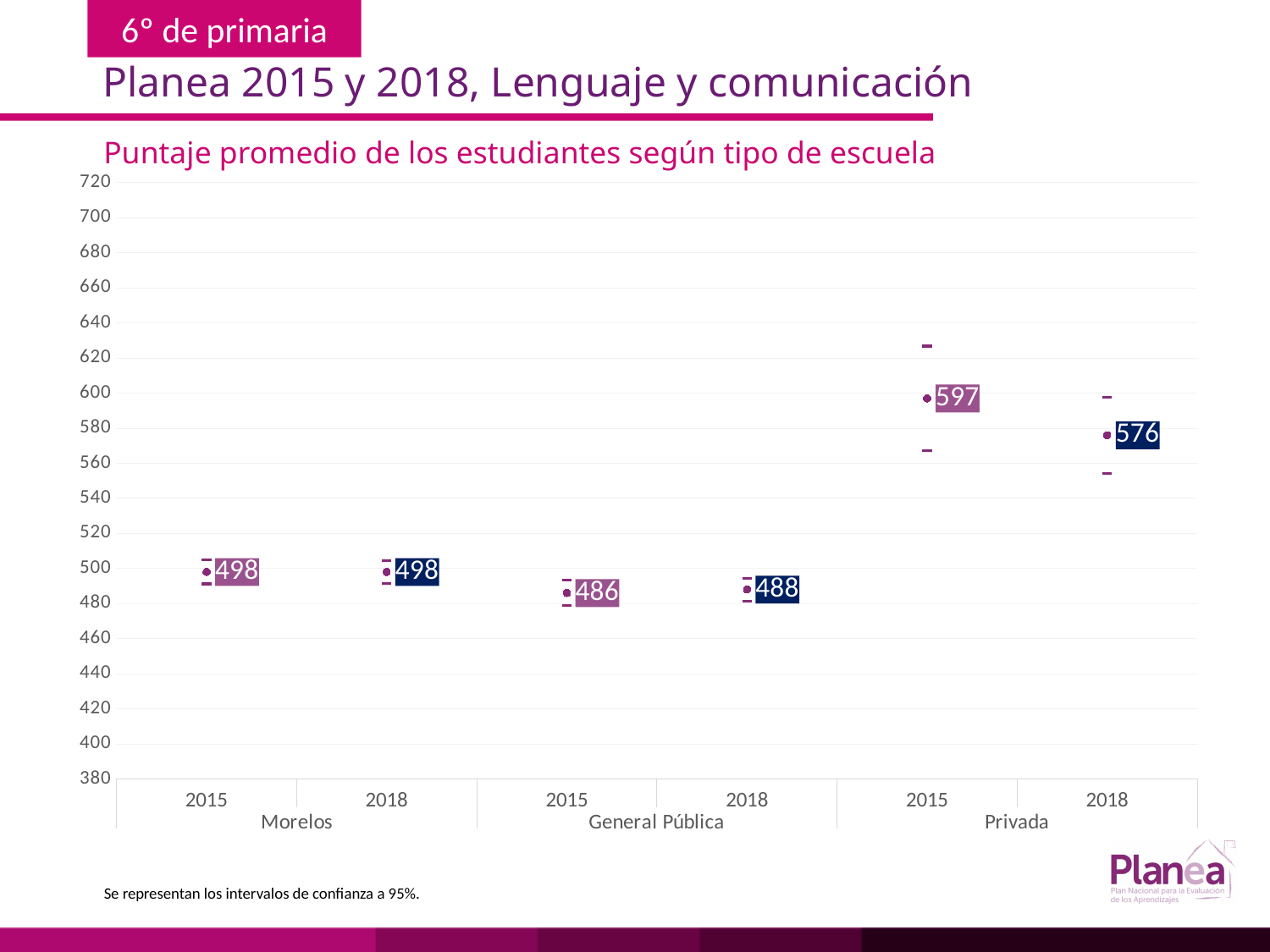
Which school type and year has the highest average score? Privada 2015 Which is larger, the General Pública score in 2015 or in 2018? 2018 What is the average score for Privada in 2015? 597 How many data points are plotted on the chart? 6 Which school type and year has the lowest average score? General Pública 2015 Did the Privada average score rise or fall from 2015 to 2018? fall What is the average score for General Pública in 2018? 488 What is the average score for Morelos in 2015? 498 What is the average score for Privada in 2018? 576 What is the title of the chart? Puntaje promedio de los estudiantes según tipo de escuela What is the difference between the Privada 2018 score and the General Pública 2018 score? 88 What is the difference between the Privada scores in 2015 and 2018? 21